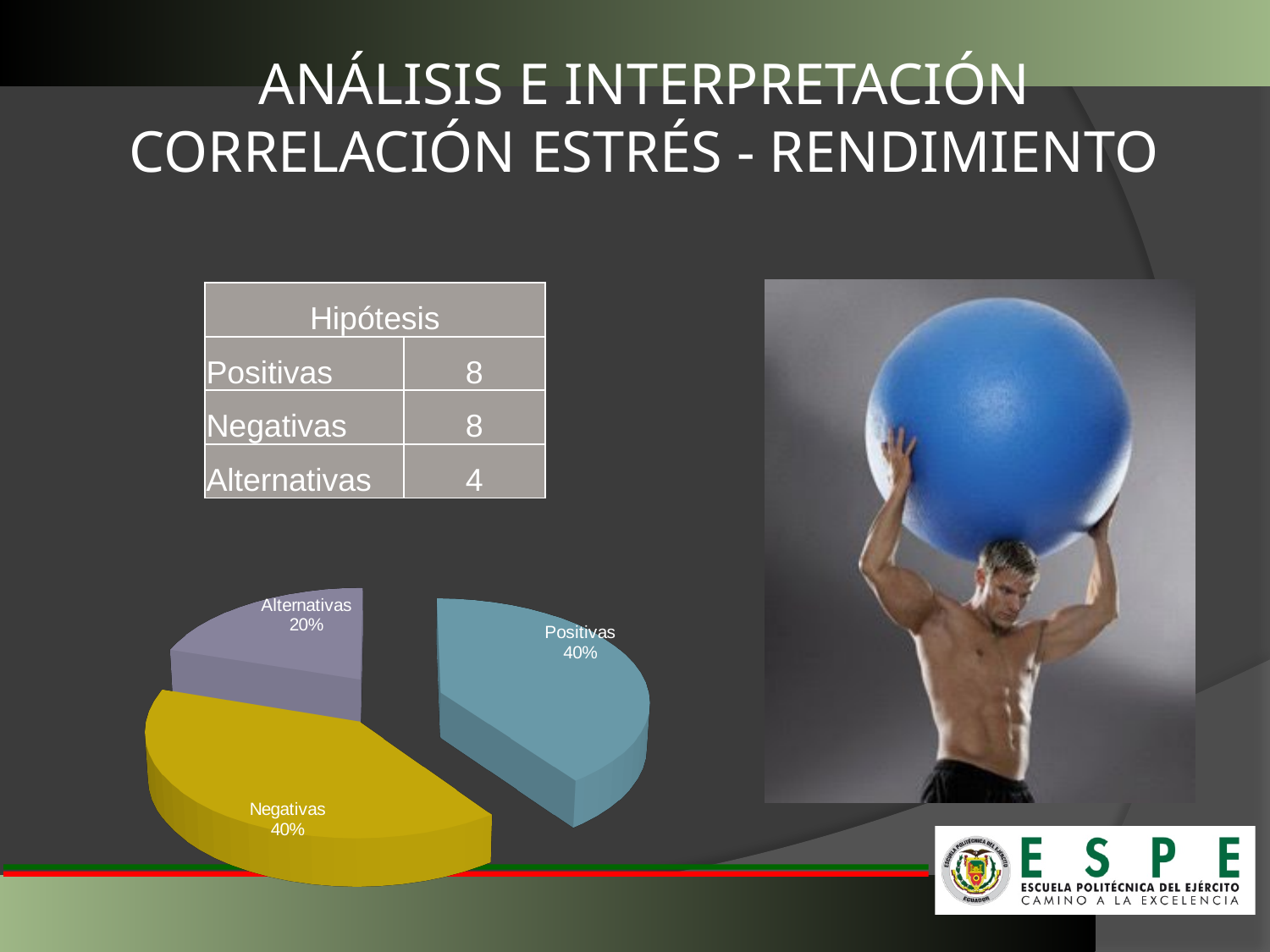
What percentage does the Positivas slice show in the pie chart? 40% What is the difference in percentage points between the Negativas and Alternativas slices? 20 How many slices does the pie chart have? 3 What percentage does the Alternativas slice show in the pie chart? 20% What percentage does the Negativas slice show in the pie chart? 40% Which slice of the pie chart is coloured blue? Positivas What kind of chart is shown on the slide? pie chart Which slice of the pie chart is coloured yellow? Negativas Which is larger in the pie chart, Positivas or Alternativas? Positivas Which slice of the pie chart is the smallest? Alternativas What share of the pie does the Alternativas slice represent? 20%